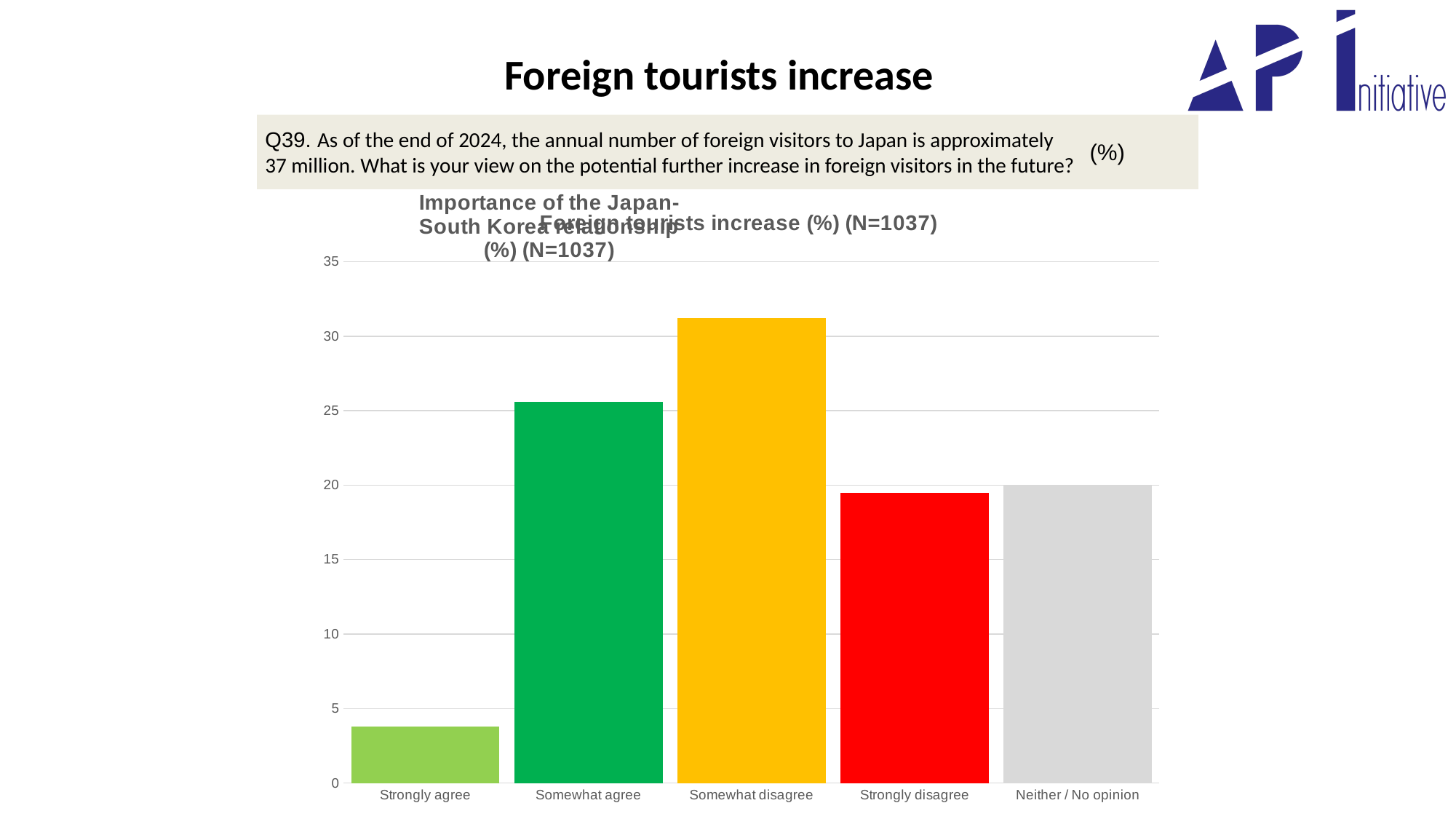
Which is larger, the value for Somewhat disagree or the value for Neither / No opinion? Somewhat disagree What colour is the bar for Somewhat disagree? yellow Is the value for Somewhat disagree greater or less than 30? greater Which response category has the lowest value in the chart? Strongly agree What sample size (N) is stated in the chart title? N=1037 Is the value for Somewhat agree greater or less than 25? greater Which is larger, the value for Somewhat agree or the value for Strongly disagree? Somewhat agree How many response categories are shown on the x axis of the chart? 5 Which response category has the highest value in the chart? Somewhat disagree Is the value for Strongly disagree greater or less than 15? greater What kind of chart is shown on the slide? bar chart